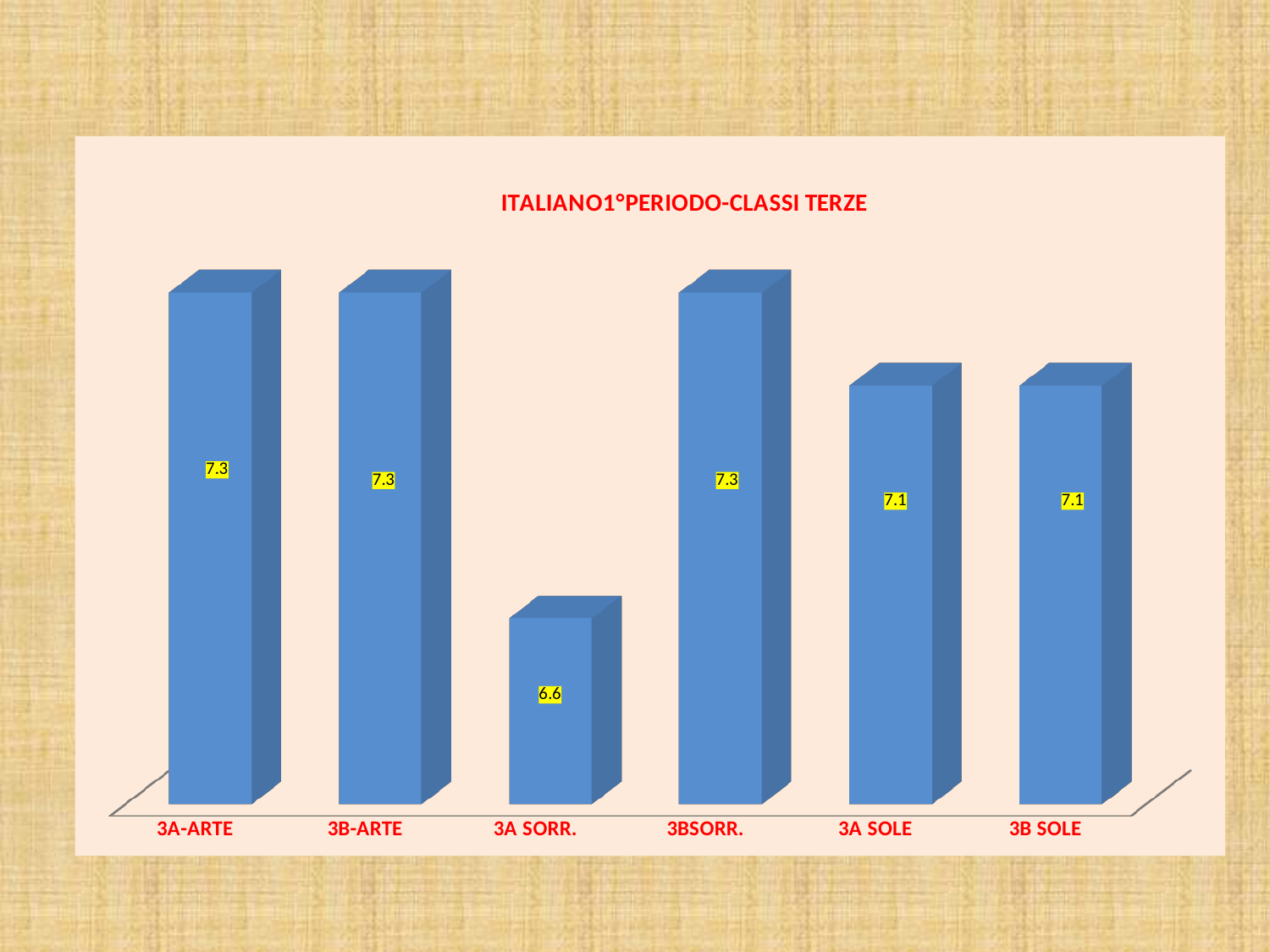
What is the value for 3B-ARTE? 7.3 What is the value for 3B SOLE? 7.1 What kind of chart is shown on the slide? Bar chart Which is larger, the value for 3BSORR. or the value for 3B SOLE? 3BSORR. What is the value for 3A SORR.? 6.6 Which category has the lowest value? 3A SORR. What is the value for 3A SOLE? 7.1 How many categories are shown on the chart? 6 What is the title of the chart? ITALIANO1°PERIODO-CLASSI TERZE Which is larger, the value for 3A SORR. or the value for 3A SOLE? 3A SOLE What is the difference between the values for 3A-ARTE and 3A SOLE? 0.2 What is the difference between the values for 3BSORR. and 3A SORR.? 0.7